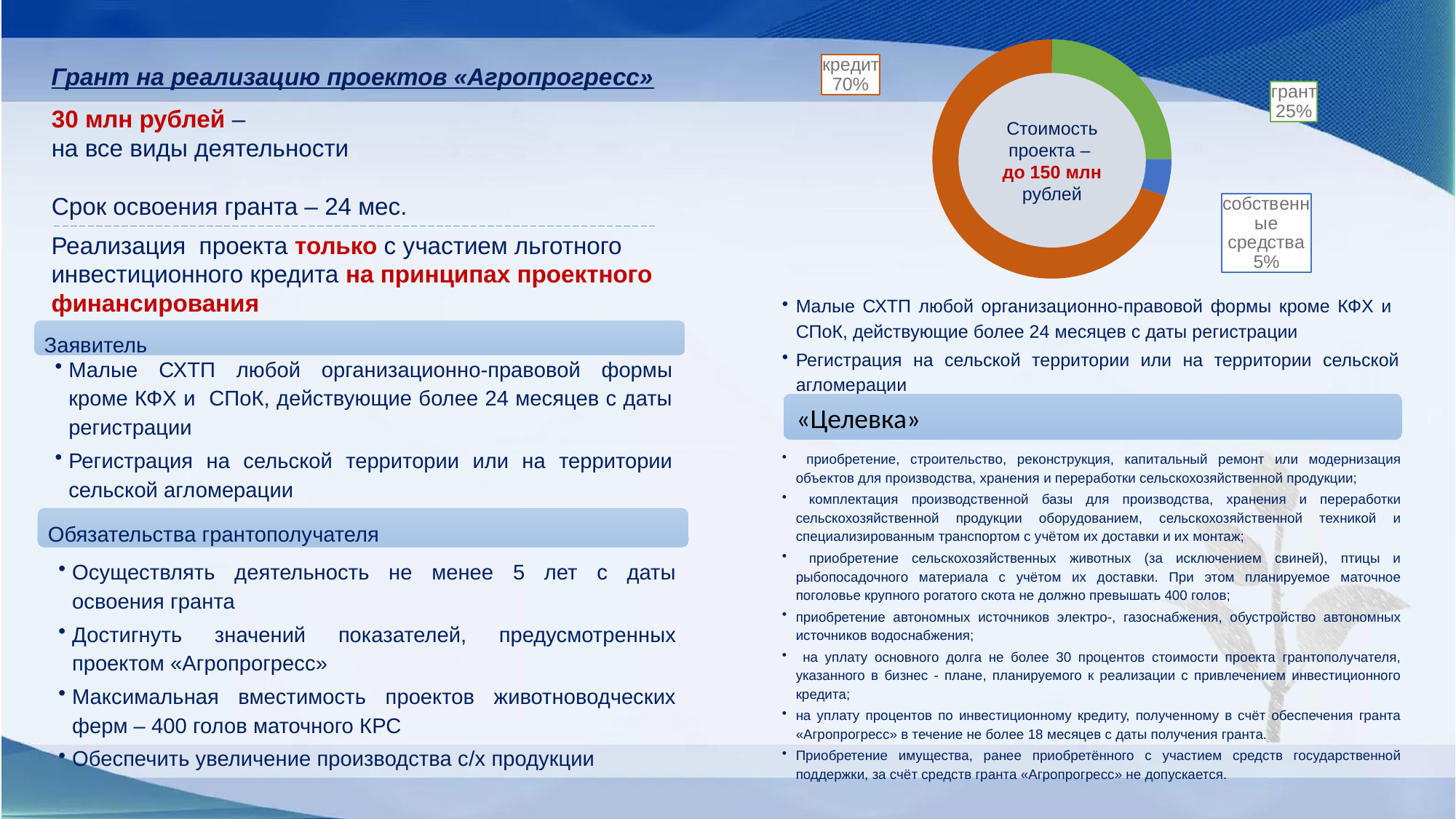
What share of the project cost does «кредит» account for in the doughnut chart? 70% Which category has the largest share in the doughnut chart? кредит What share of the project cost do «собственные средства» account for in the doughnut chart? 5% What is the difference in percentage points between the «кредит» share and the «грант» share? 45 How many categories are shown in the doughnut chart? 3 Which category has the smallest share in the doughnut chart? собственные средства What colour is the «кредит» slice in the doughnut chart? orange What kind of chart is shown on the slide? doughnut chart What is the combined share of «грант» and «собственные средства» in the doughnut chart? 30% Which is larger in the doughnut chart, the share of «грант» or the share of «собственные средства»? грант What text is written in the centre of the doughnut chart? Стоимость проекта – до 150 млн рублей What share of the project cost does «грант» account for in the doughnut chart? 25%